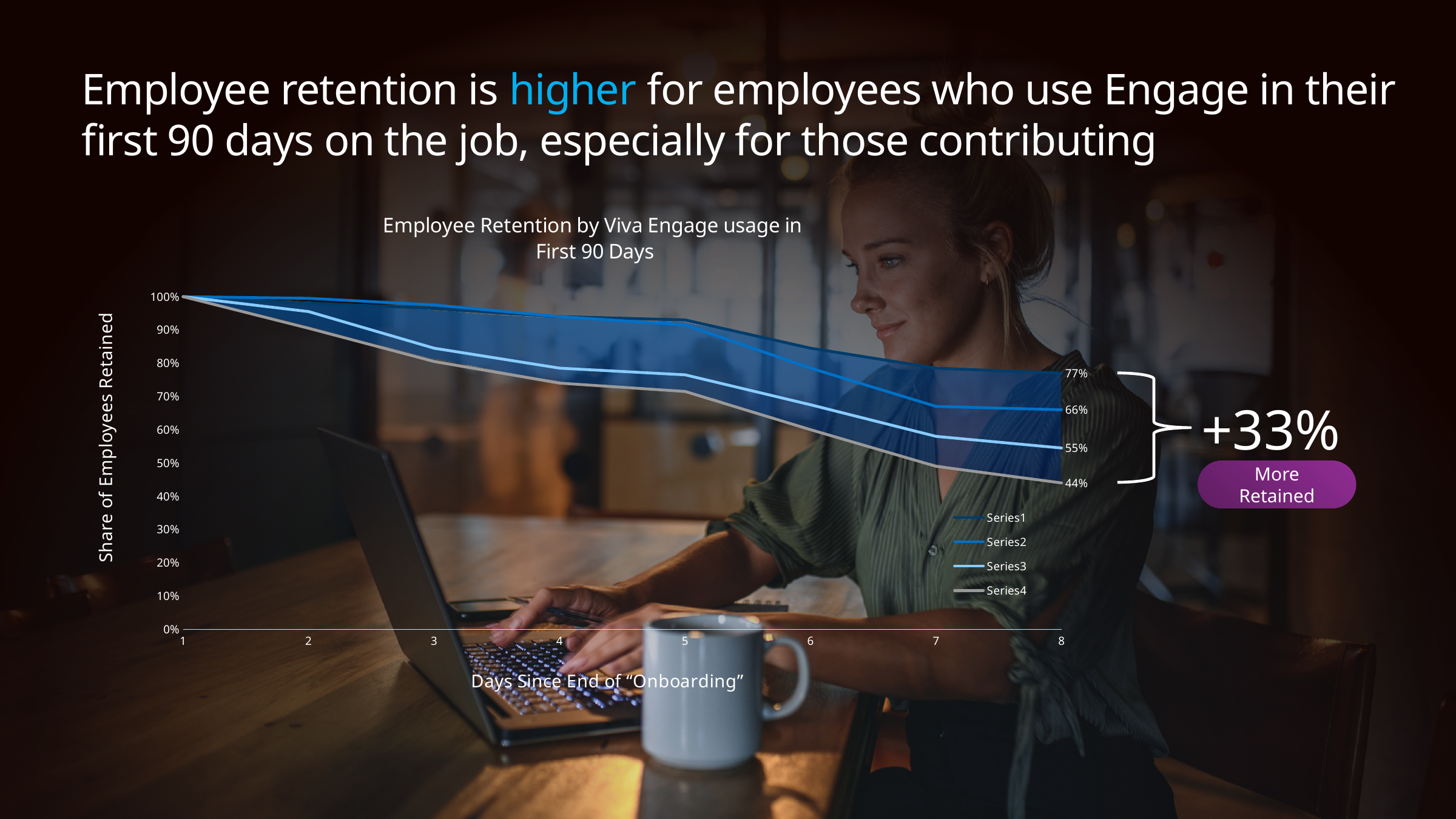
At day 8, which is larger: the value labelled 66% or the value labelled 55%? 66% What kind of chart is shown on the slide? line chart How many points are on the x axis (days since end of onboarding)? 8 What is the value of the grey line (Series4) at day 8? 44% What value do all series start at on day 1? 100% Which series has the lowest value at day 8? Series4 What is the title of the chart? Employee Retention by Viva Engage usage in First 90 Days How many series does the legend list? 4 What is the difference between the highest (77%) and lowest (44%) values at day 8? 33% Do the retention values rise or fall as days since end of onboarding increase? fall What is the highest retention value shown at day 8? 77%